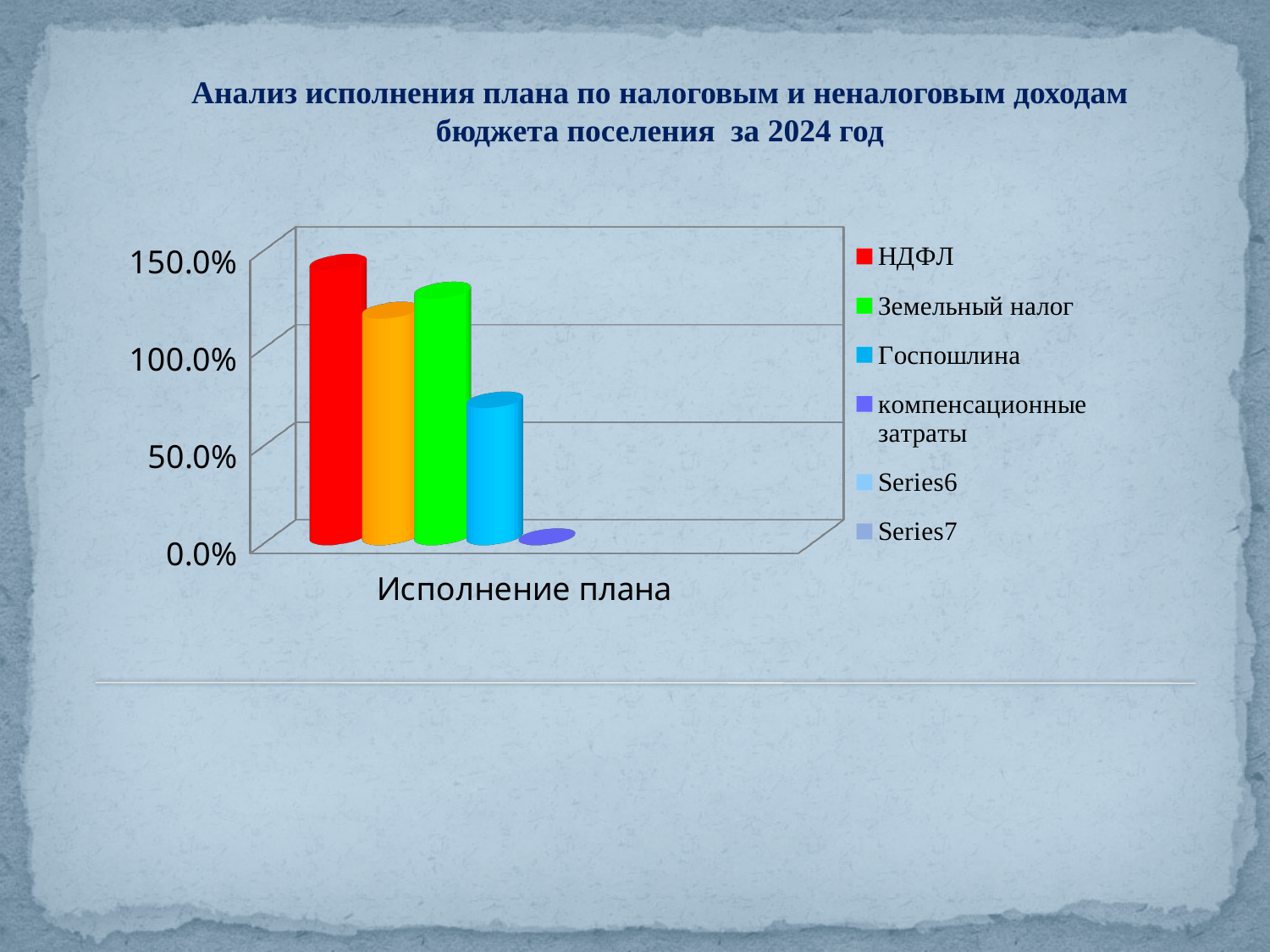
What colour is the bar for НДФЛ? red Which is larger, the value for НДФЛ or the value for Госпошлина? НДФЛ Which series has the lowest value? компенсационные затраты Which series has the highest value? НДФЛ Is the value for Земельный налог greater or less than 100.0%? greater What kind of chart is shown on the slide? bar chart Is the value for НДФЛ greater or less than 100.0%? greater What is the label of the category on the x axis? Исполнение плана How many series does the legend list? 6 Is the value for Госпошлина greater or less than 100.0%? less How many categories are shown on the x axis? 1